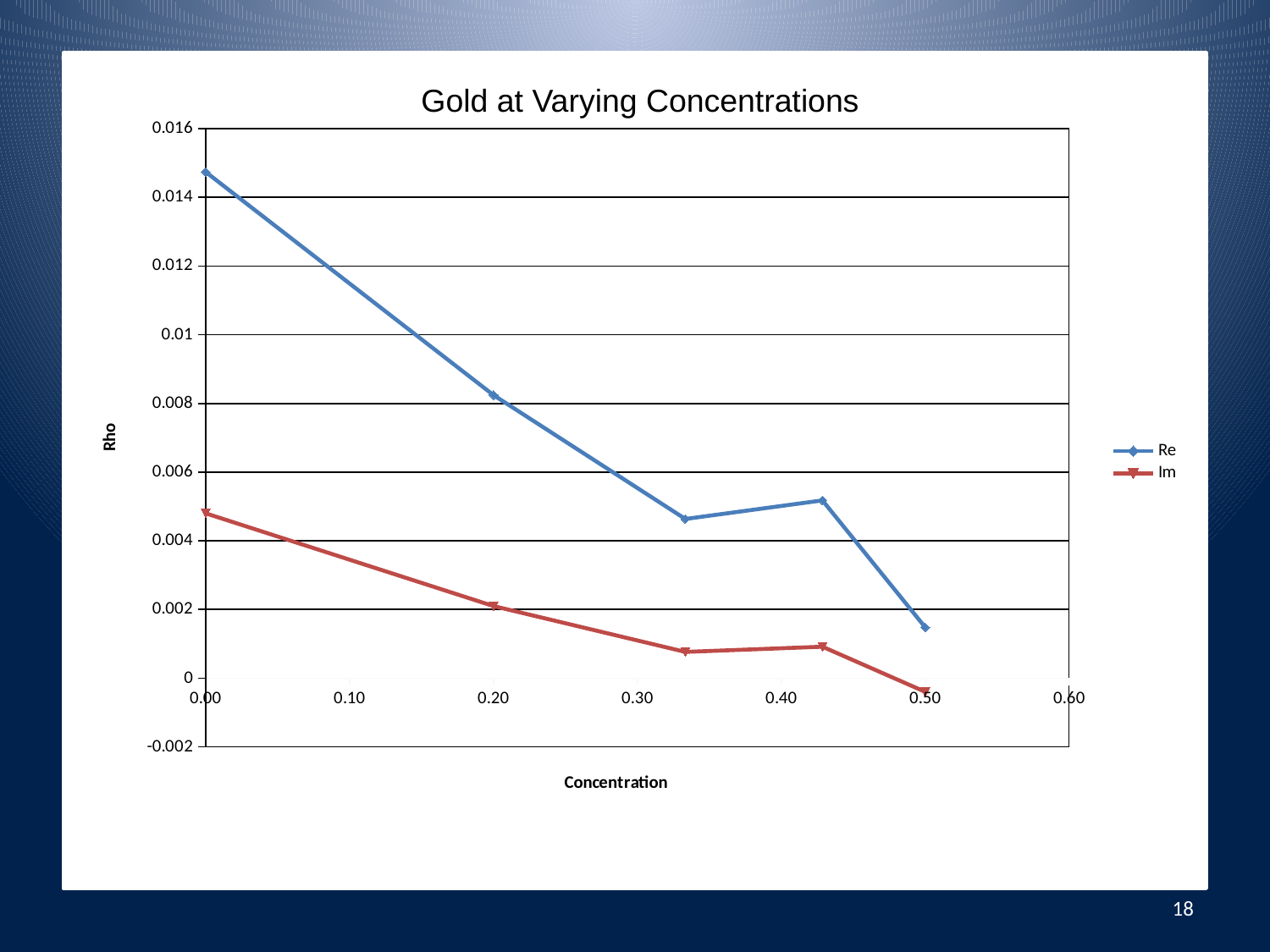
Is the value of Re at Concentration 0.50 greater or less than 0.002? less What is the title of the chart? Gold at Varying Concentrations How many data points does the Re series have? 5 What kind of chart is shown on the slide? line chart How many series does the legend list? 2 Is the value of Re at Concentration 0.20 greater or less than 0.006? greater Do the values of the Im series generally rise or fall as Concentration increases? fall At Concentration 0.00, which series has the larger value, Re or Im? Re Which series is drawn in red? Im At which Concentration does the Re series reach its highest value? 0.00 Is the value of Re at Concentration 0.00 greater or less than 0.014? greater